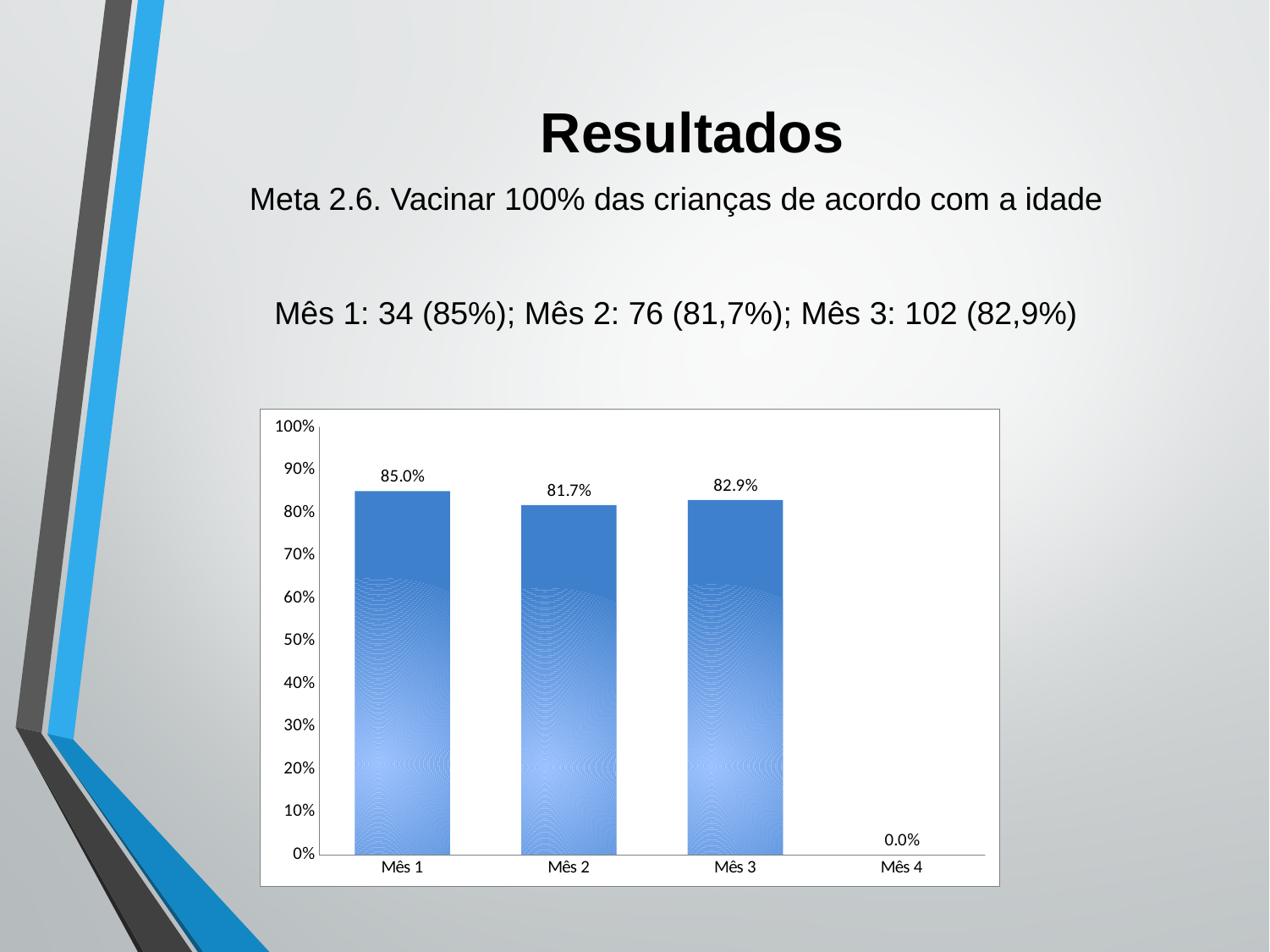
What is the highest value shown on the y axis? 100% What is the difference between the values for Mês 1 and Mês 2? 3.3% How many categories are shown on the x axis? 4 What is the value for Mês 1? 85.0% What is the value for Mês 4? 0.0% What kind of chart is shown on the slide? bar chart Which category has the lowest value? Mês 4 What is the value for Mês 2? 81.7% What is the value for Mês 3? 82.9% Is the value for Mês 3 greater or less than 80%? greater Which is larger, the value for Mês 2 or Mês 3? Mês 3 Which category has the highest value? Mês 1